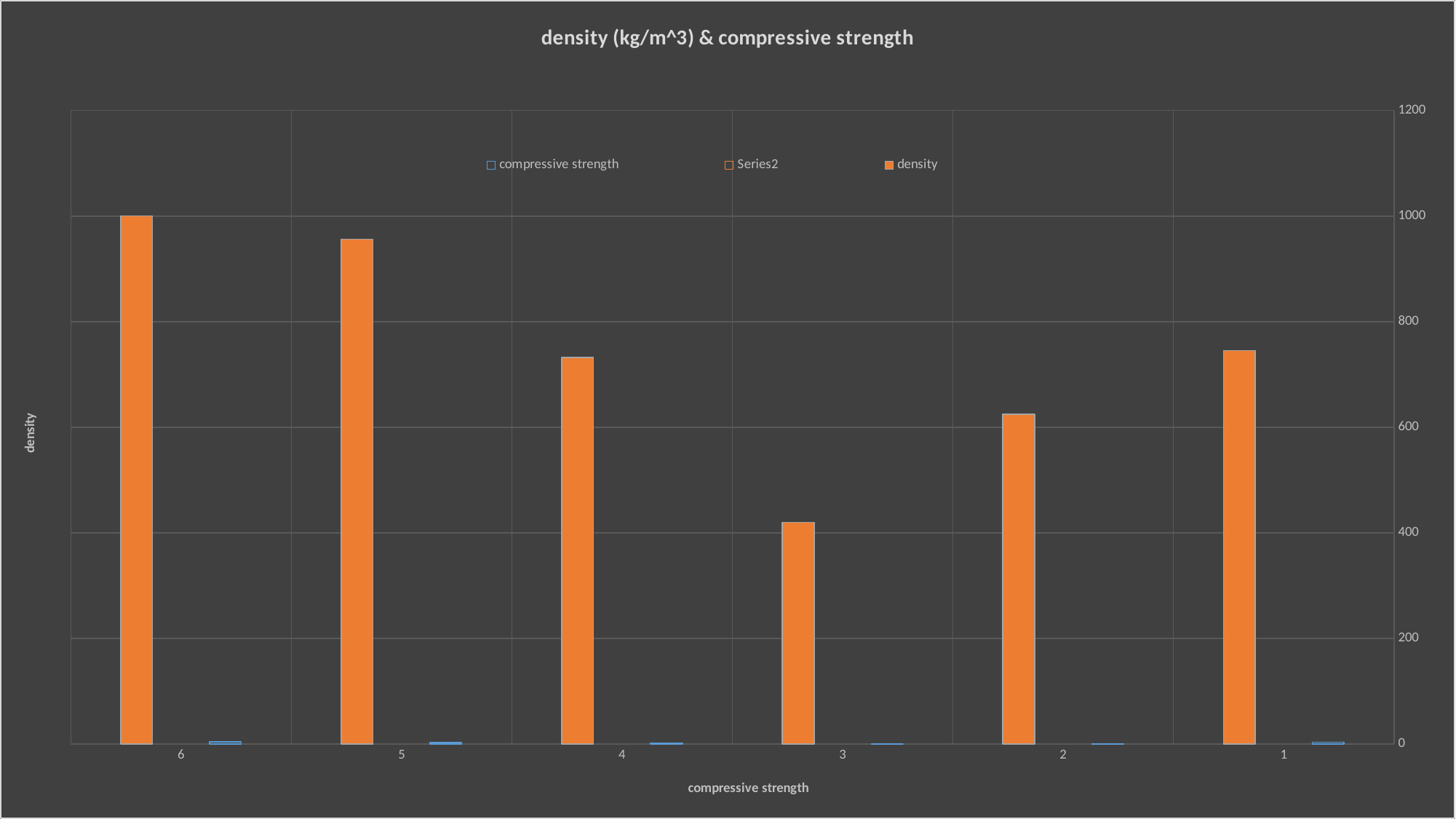
Is the density value for category 2 greater or less than 600? greater What is the label on the vertical axis? density Which category has the lowest density bar? 3 What is the title of the chart? density (kg/m^3) & compressive strength Is the density value for category 3 greater or less than 600? less Which has a larger density bar, category 5 or category 2? 5 How many series does the legend list? 3 Which category has the highest density bar? 6 Is the density value for category 5 greater or less than 800? greater What kind of chart is shown on the slide? bar chart How many categories are shown on the x axis? 6